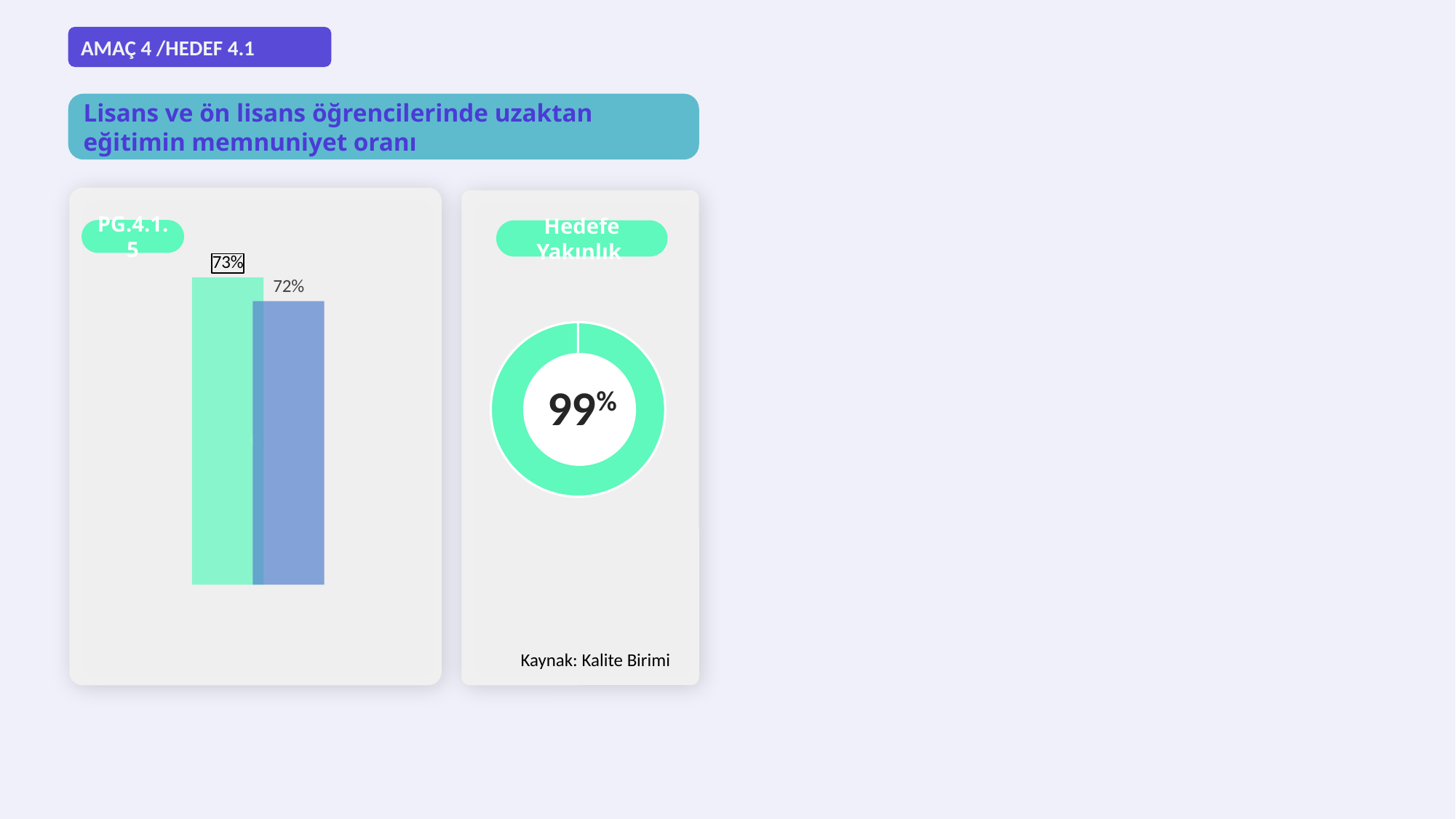
What is the indicator code shown in the label of the left chart panel? PG.4.1.5 What kind of chart is shown in the 'Hedefe Yakınlık' panel? donut chart In the bar chart on the left (PG.4.1.5), what value is printed above the blue bar? 72% What source is cited below the 'Hedefe Yakınlık' chart? Kaynak: Kalite Birimi What percentage is shown in the centre of the 'Hedefe Yakınlık' donut chart? 99% In the bar chart on the left (PG.4.1.5), which bar is taller, the green one or the blue one? the green one In the bar chart on the left (PG.4.1.5), what is the difference between the green bar's value and the blue bar's value? 1% In the bar chart on the left (PG.4.1.5), what value is printed above the green bar? 73% What kind of chart is shown in the left panel labelled PG.4.1.5? bar chart How many bars are plotted in the bar chart on the left (PG.4.1.5)? 2 In the bar chart on the left (PG.4.1.5), which bar has the lowest value? the blue bar (72%)